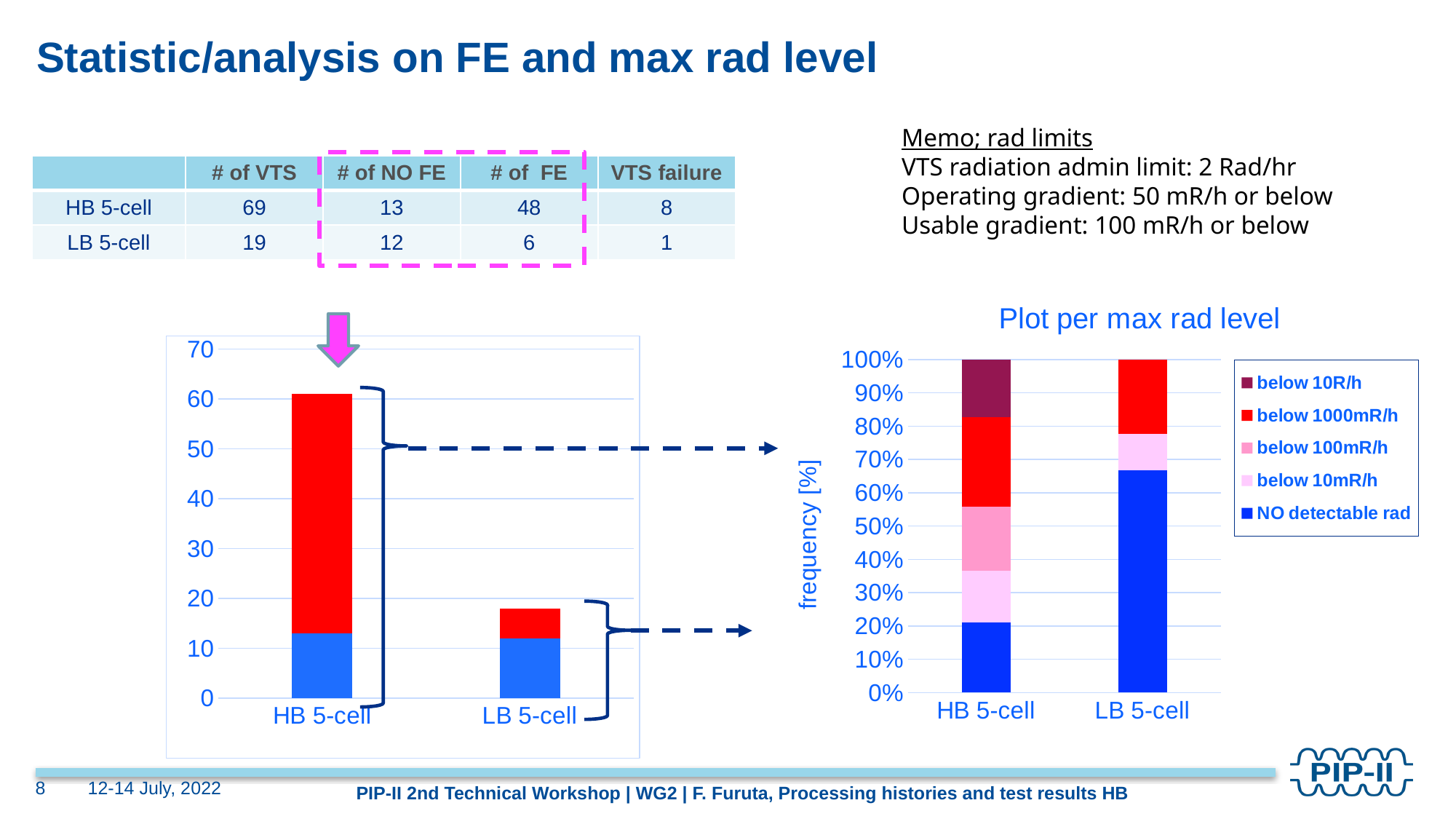
How many series does the legend of the 'Plot per max rad level' chart list? 5 In the left chart, is the total height of the LB 5-cell bar greater or less than 20? less In the left chart, which category has the taller bar, HB 5-cell or LB 5-cell? HB 5-cell In the 'Plot per max rad level' chart, is the 'NO detectable rad' share for HB 5-cell greater or less than 30%? less In the left chart, which category has the larger red segment, HB 5-cell or LB 5-cell? HB 5-cell How many categories are shown on the x axis of the left chart? 2 What is the title of the chart on the right of the slide? Plot per max rad level In the left chart, is the total height of the HB 5-cell bar greater or less than 50? greater In the 'Plot per max rad level' chart, which category has the larger 'NO detectable rad' share, HB 5-cell or LB 5-cell? LB 5-cell What kind of chart is the chart on the left of the slide? bar chart In the 'Plot per max rad level' chart, which category has a 'below 10R/h' segment? HB 5-cell